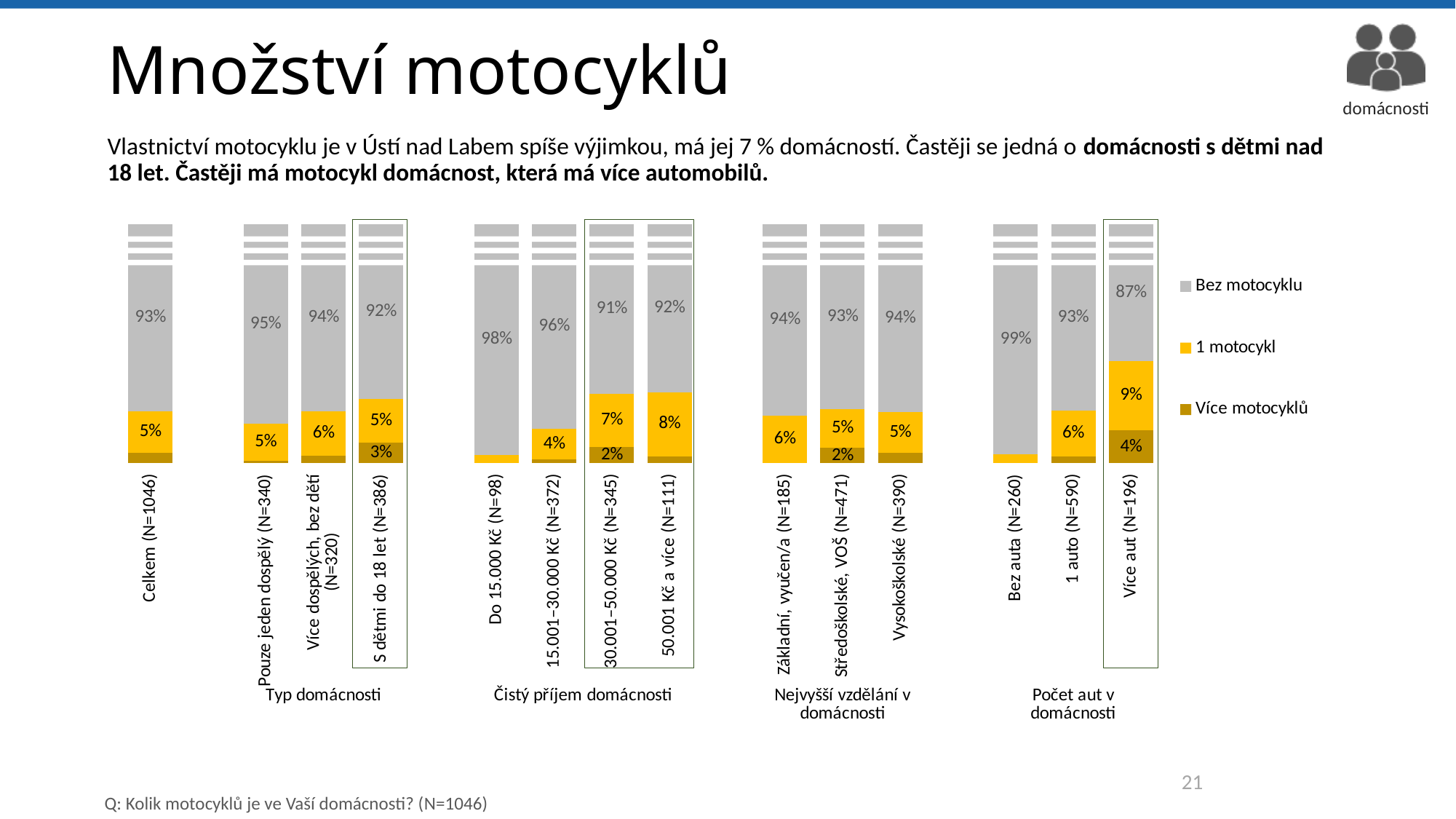
What percentage of households in the 'Celkem (N=1046)' category have no motorcycle ('Bez motocyklu')? 93% What is the difference between the 'Bez motocyklu' values for 'Bez auta (N=260)' and 'Více aut (N=196)'? 12% Which series is shown in the light grey colour in the legend? Bez motocyklu Which has a larger '1 motocykl' value: '30.001–50.000 Kč (N=345)' or '50.001 Kč a více (N=111)'? 50.001 Kč a více (N=111) Which category has the lowest 'Bez motocyklu' share? Více aut (N=196) How many series does the legend list? 3 Which category has the highest 'Bez motocyklu' share? Bez auta (N=260) What kind of chart is shown on the slide? Stacked bar chart What is the '1 motocykl' value for the 'Více aut (N=196)' category? 9% What is the 'Více motocyklů' value for the 'S dětmi do 18 let (N=386)' category? 3% How many bars (categories) are plotted in the chart? 14 What is the 'Bez motocyklu' value for the 'Do 15.000 Kč (N=98)' category? 98%